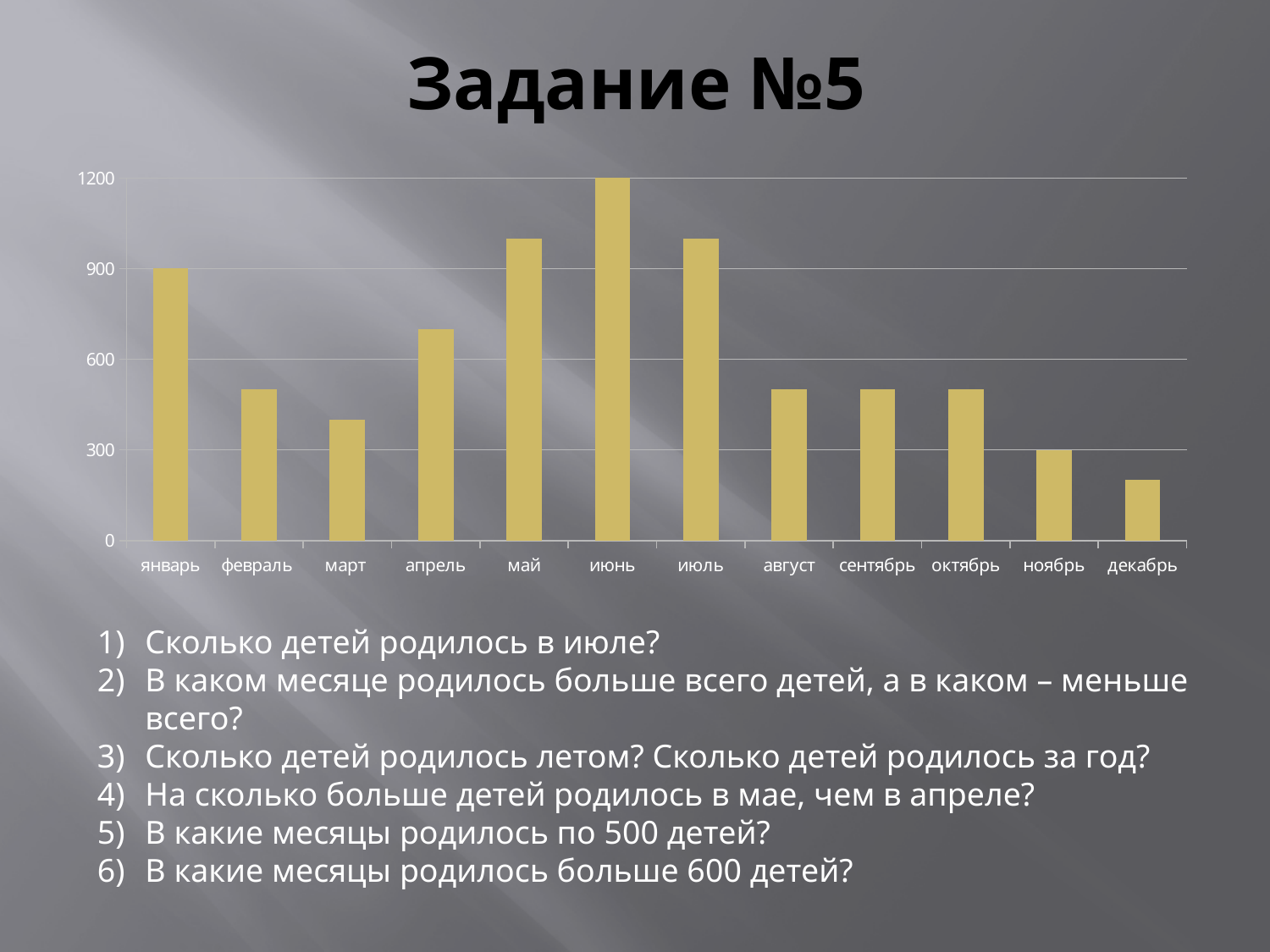
What is the value for июнь in the chart? 1200 Which month has the highest bar in the chart? июнь Is the value for май greater or less than 900? greater What is the difference between the values for июнь and январь? 300 Do the values rise or fall along the x axis from июнь to декабрь? fall What is the value for январь in the chart? 900 Is the value for февраль greater or less than 600? less How many months (categories) are shown on the x axis of the chart? 12 What kind of chart is shown on the slide? bar chart Which month has the lowest bar in the chart? декабрь What is the value for ноябрь in the chart? 300 Which is larger, the value for май or the value for апрель? май